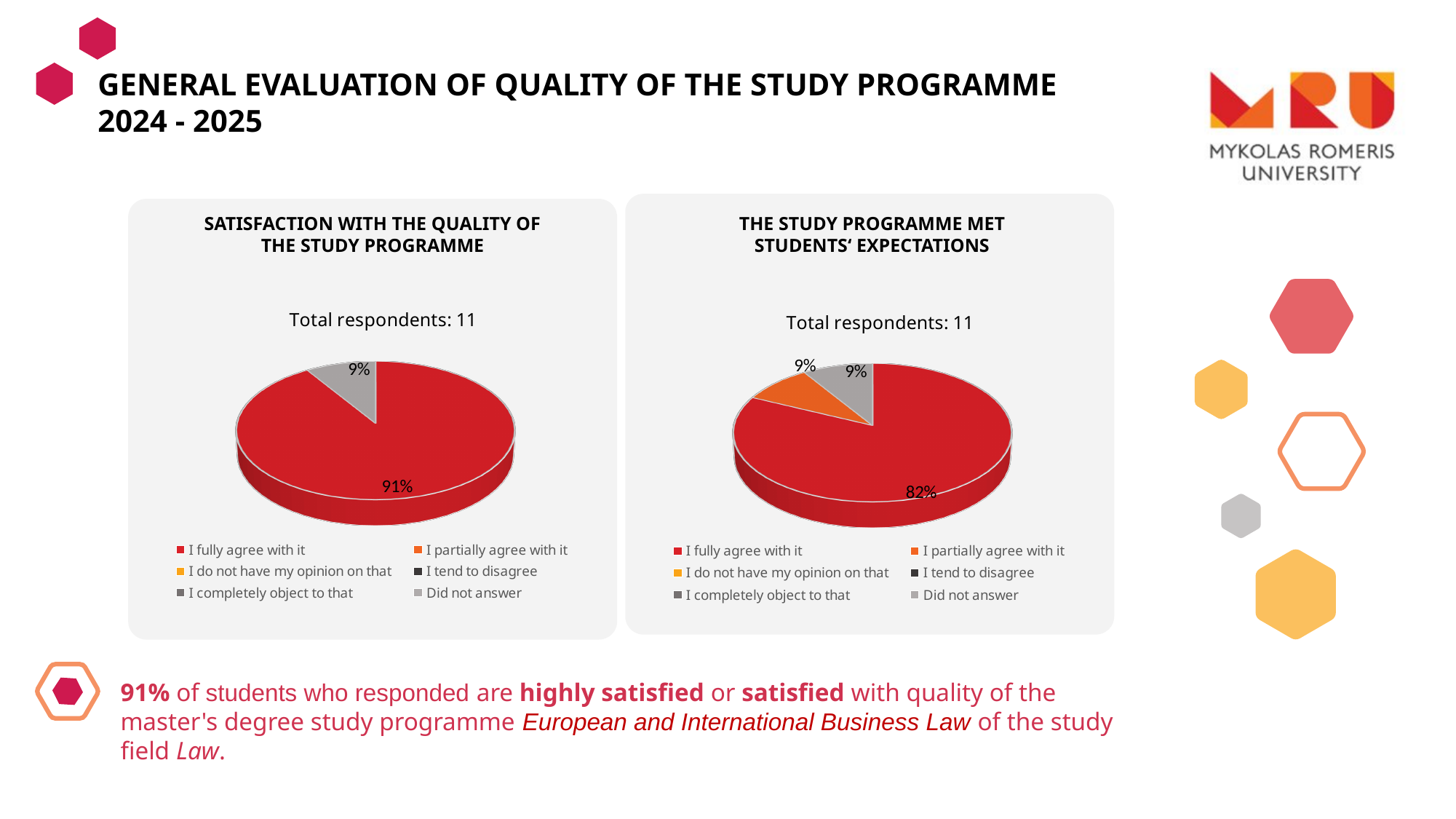
How many entries does the legend of the 'Satisfaction with the quality of the study programme' chart list? 6 In the 'Satisfaction with the quality of the study programme' chart, what share of respondents chose 'I fully agree with it'? 91% What is the difference between the 'I fully agree with it' share in the 'Satisfaction with the quality of the study programme' chart and the same share in the 'The study programme met students' expectations' chart? 9% What kind of chart is used in the 'Satisfaction with the quality of the study programme' panel? Pie chart How many slices are visible in the 'The study programme met students' expectations' pie chart? 3 In the 'The study programme met students' expectations' chart, what share of respondents chose 'I fully agree with it'? 82% In the 'The study programme met students' expectations' chart, what share of respondents chose 'I partially agree with it'? 9% In the 'Satisfaction with the quality of the study programme' chart, which response has the smallest slice? Did not answer How many slices are visible in the 'Satisfaction with the quality of the study programme' pie chart? 2 In the 'The study programme met students' expectations' chart, which response has the largest slice? I fully agree with it How many total respondents are reported for the 'The study programme met students' expectations' chart? 11